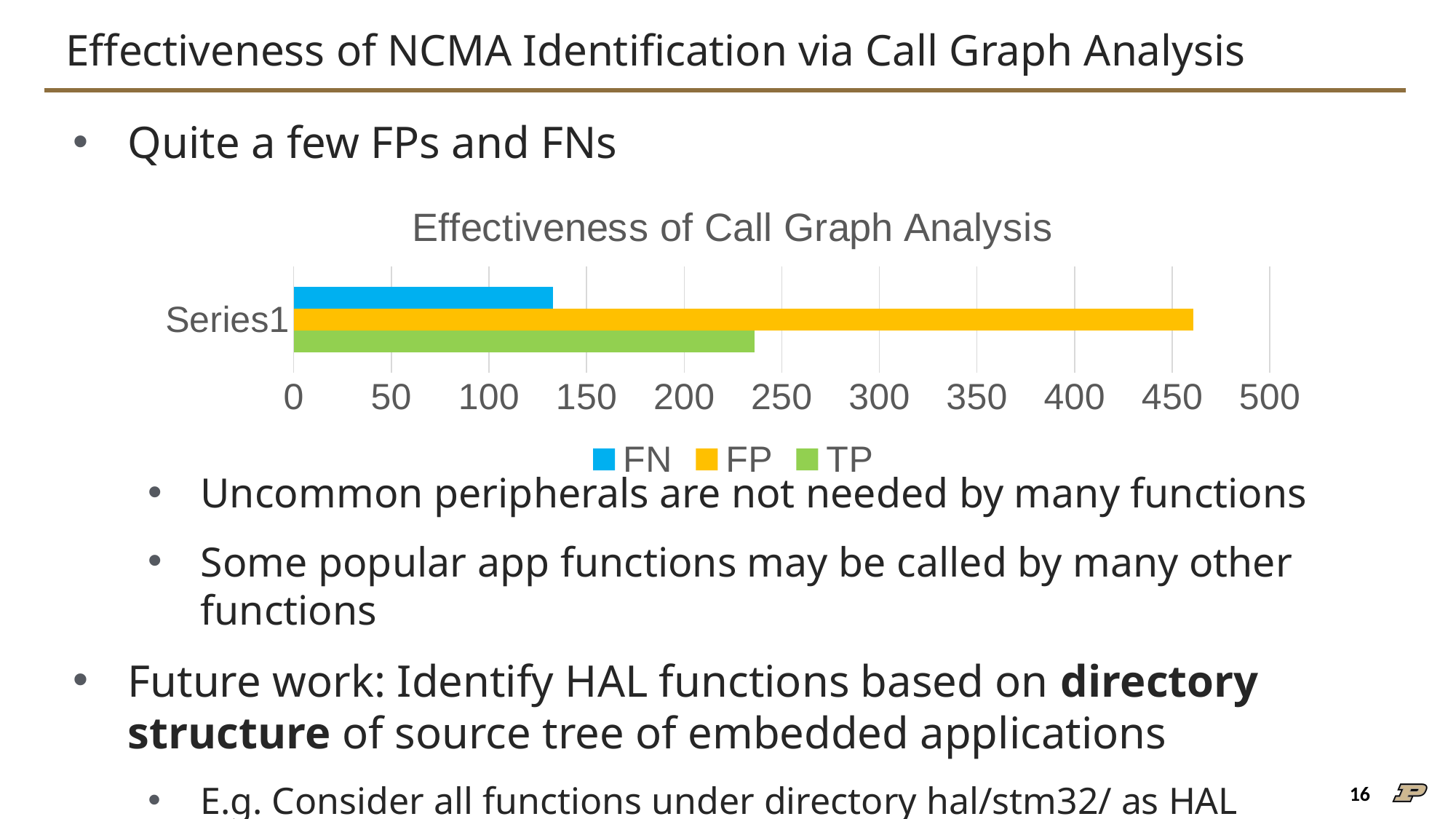
Which is larger, the value for FP or the value for TP? FP What kind of chart is shown on the slide? bar chart Which series has the shortest bar in the chart? FN Is the value for FN greater or less than 150? less What colour is the FP series in the chart? orange Is the value for TP greater or less than 200? greater Which series has the longest bar in the chart? FP How many categories are shown on the vertical axis of the chart? 1 Is the value for FP greater or less than 400? greater Which is larger, the value for TP or the value for FN? TP What is the title of the chart? Effectiveness of Call Graph Analysis How many series does the chart legend list? 3